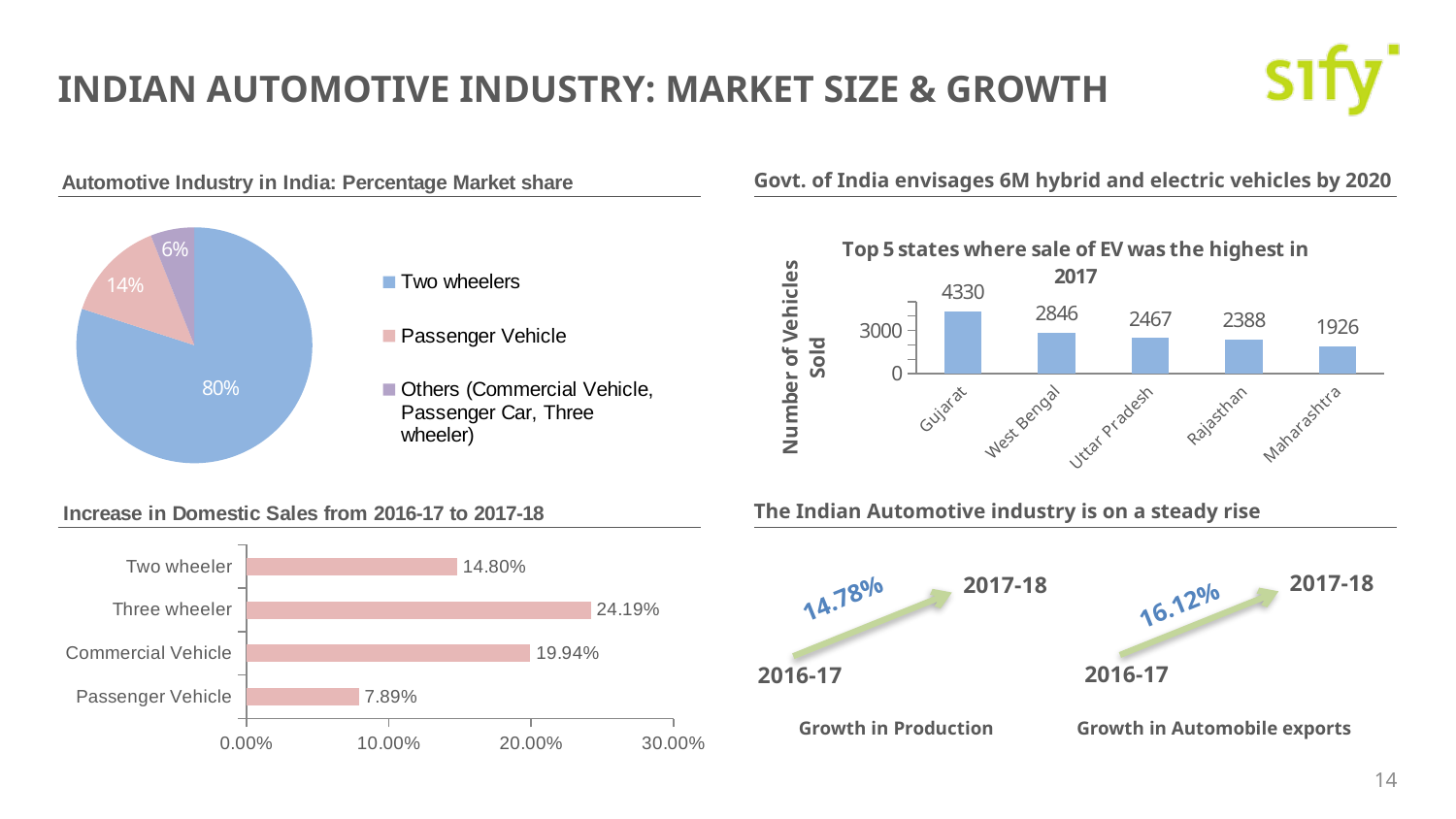
In the chart 'Increase in Domestic Sales from 2016-17 to 2017-18', which category has the highest value? Three wheeler In the chart 'Top 5 states where sale of EV was the highest in 2017', which state has the lowest number of vehicles sold? Maharashtra In the pie chart 'Automotive Industry in India: Percentage Market share', which category has the smallest share? Others (Commercial Vehicle, Passenger Car, Three wheeler) What kind of chart is 'Increase in Domestic Sales from 2016-17 to 2017-18'? Bar chart In the chart 'Top 5 states where sale of EV was the highest in 2017', what is the y-axis title? Number of Vehicles Sold In the pie chart 'Automotive Industry in India: Percentage Market share', what share do Two wheelers hold? 80% In the pie chart 'Automotive Industry in India: Percentage Market share', how many slices are there? 3 In the chart 'Increase in Domestic Sales from 2016-17 to 2017-18', which is larger: Two wheeler or Passenger Vehicle? Two wheeler In the chart 'Top 5 states where sale of EV was the highest in 2017', what is the difference between Gujarat and West Bengal? 1484 In the chart 'Increase in Domestic Sales from 2016-17 to 2017-18', what is the value for Commercial Vehicle? 19.94% In the pie chart 'Automotive Industry in India: Percentage Market share', what share does Passenger Vehicle hold? 14% In the chart 'Top 5 states where sale of EV was the highest in 2017', what is the value for Gujarat? 4330